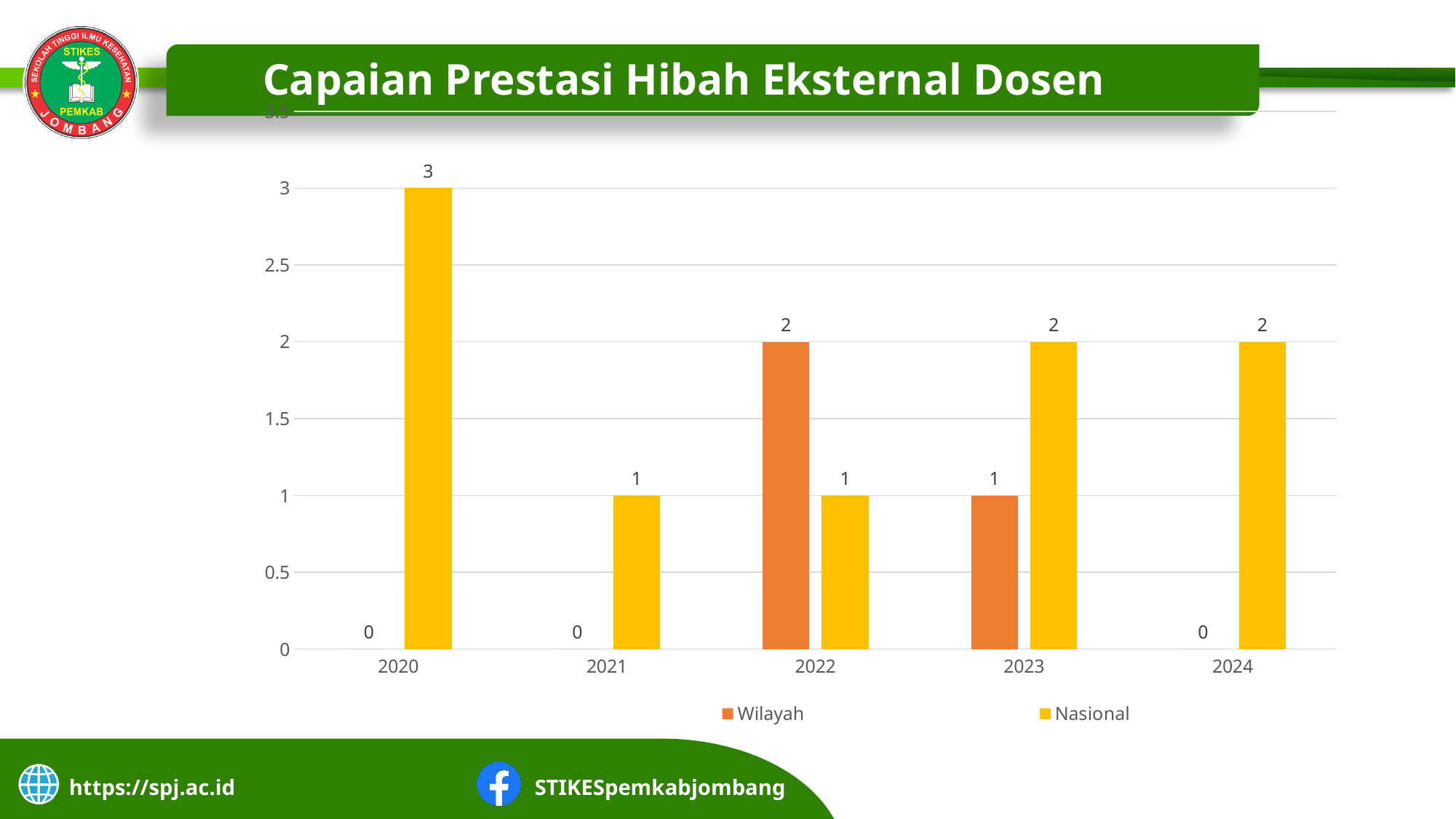
What is the Nasional value for 2021? 1 What is the Wilayah value for 2024? 0 How many years are shown on the x axis? 5 Which year has the highest Nasional value? 2020 What is the title of the chart? Capaian Prestasi Hibah Eksternal Dosen What is the Wilayah value for 2022? 2 Which year has the highest Wilayah value? 2022 Which is larger in 2022, the Wilayah value or the Nasional value? Wilayah How many series does the legend list? 2 What is the Nasional value for 2020? 3 What kind of chart is shown on the slide? Bar chart What is the difference between the Nasional values for 2020 and 2021? 2